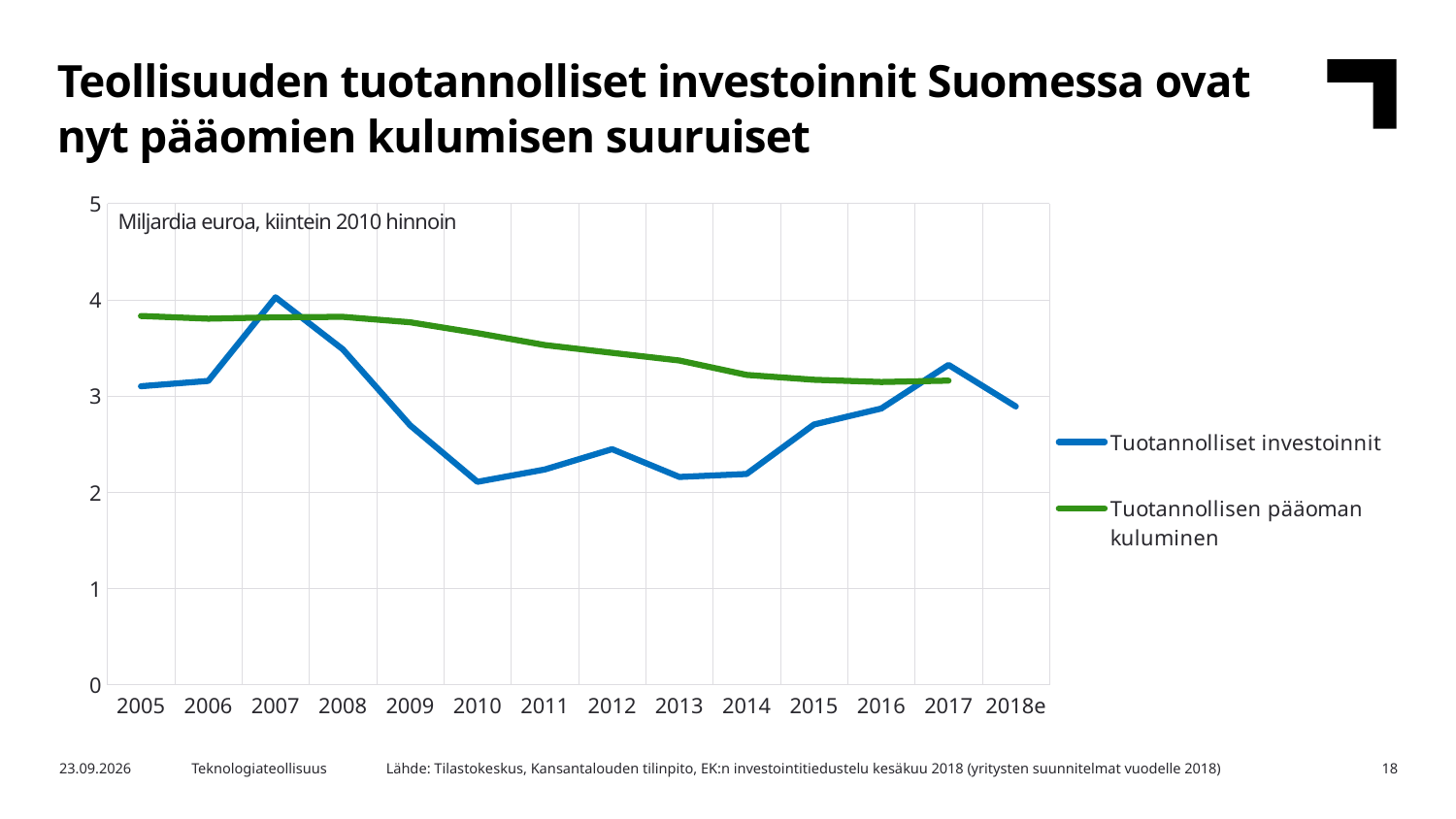
In 2007, which series has the higher value, Tuotannolliset investoinnit or Tuotannollisen pääoman kuluminen? Tuotannolliset investoinnit Is the value for Tuotannolliset investoinnit in 2010 greater or less than 3? less How many years are shown on the x axis? 14 Is the value for Tuotannolliset investoinnit in 2007 greater or less than 3? greater Does the Tuotannollisen pääoman kuluminen series rise or fall from 2005 to 2017? fall What kind of chart is shown on the slide? line chart Is the value for Tuotannollisen pääoman kuluminen in 2005 greater or less than 3? greater What unit label is shown inside the chart area? Miljardia euroa, kiintein 2010 hinnoin How many series does the legend list? 2 In which year does the Tuotannolliset investoinnit series reach its highest value? 2007 In 2010, which series has the higher value, Tuotannolliset investoinnit or Tuotannollisen pääoman kuluminen? Tuotannollisen pääoman kuluminen